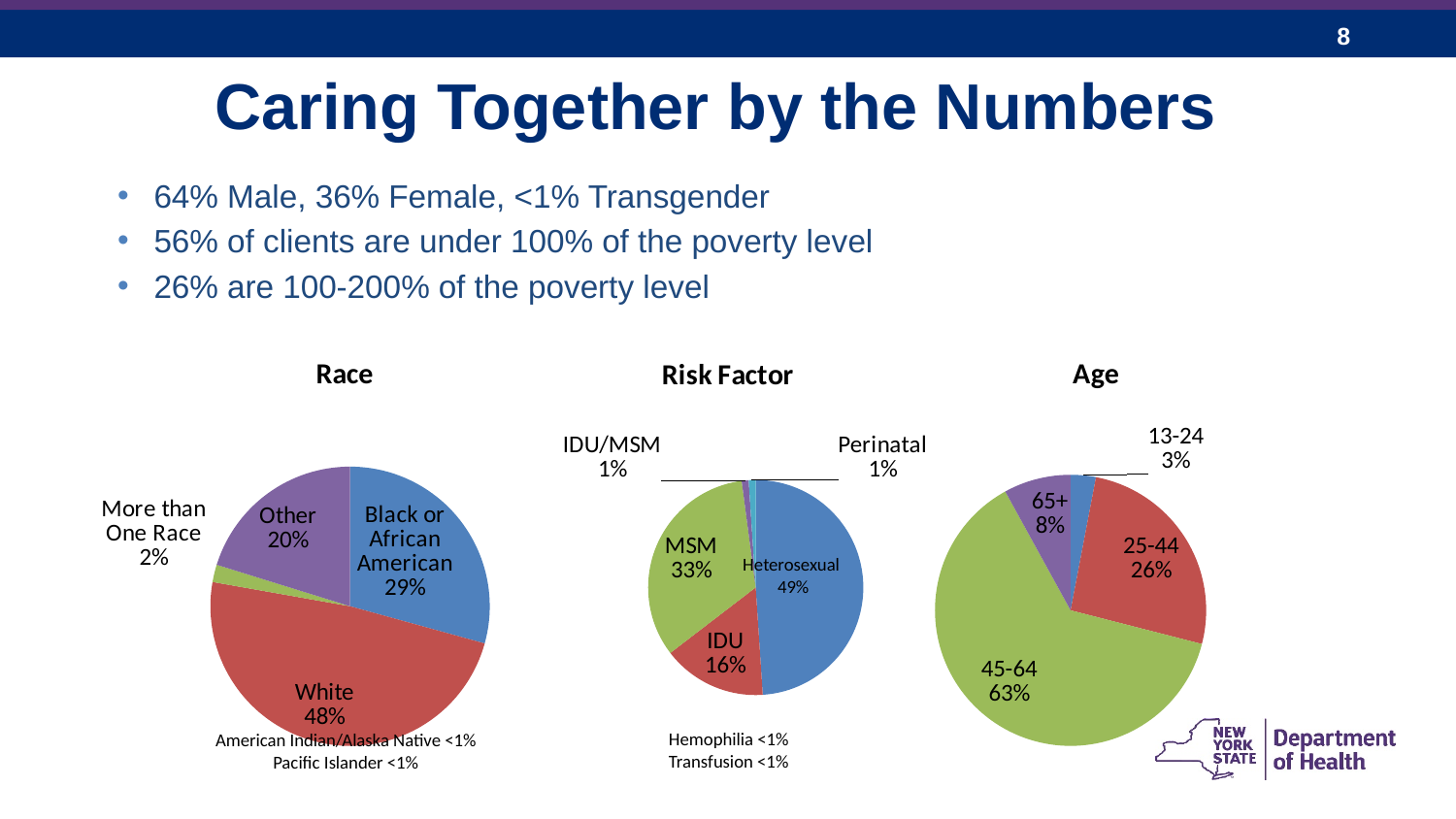
In the Race pie chart, which labelled category has the largest share? White In the Age pie chart, what share is labelled for 45-64? 63% In the Race pie chart, what share is labelled for Black or African American? 29% In the Risk Factor pie chart, which labelled category has the largest share? Heterosexual In the Age pie chart, which labelled age group has the smallest share? 13-24 In the Age pie chart, what is the difference between the 45-64 share and the 25-44 share? 37% What type of chart is used for the Age chart? Pie chart In the Race pie chart, what share is labelled for White? 48% In the Race pie chart, what is the difference between the White share and the Other share? 28% In the Risk Factor pie chart, which is larger, MSM or IDU? MSM In the Risk Factor pie chart, what share is labelled for IDU? 16% In the Risk Factor pie chart, what share is labelled for MSM? 33%